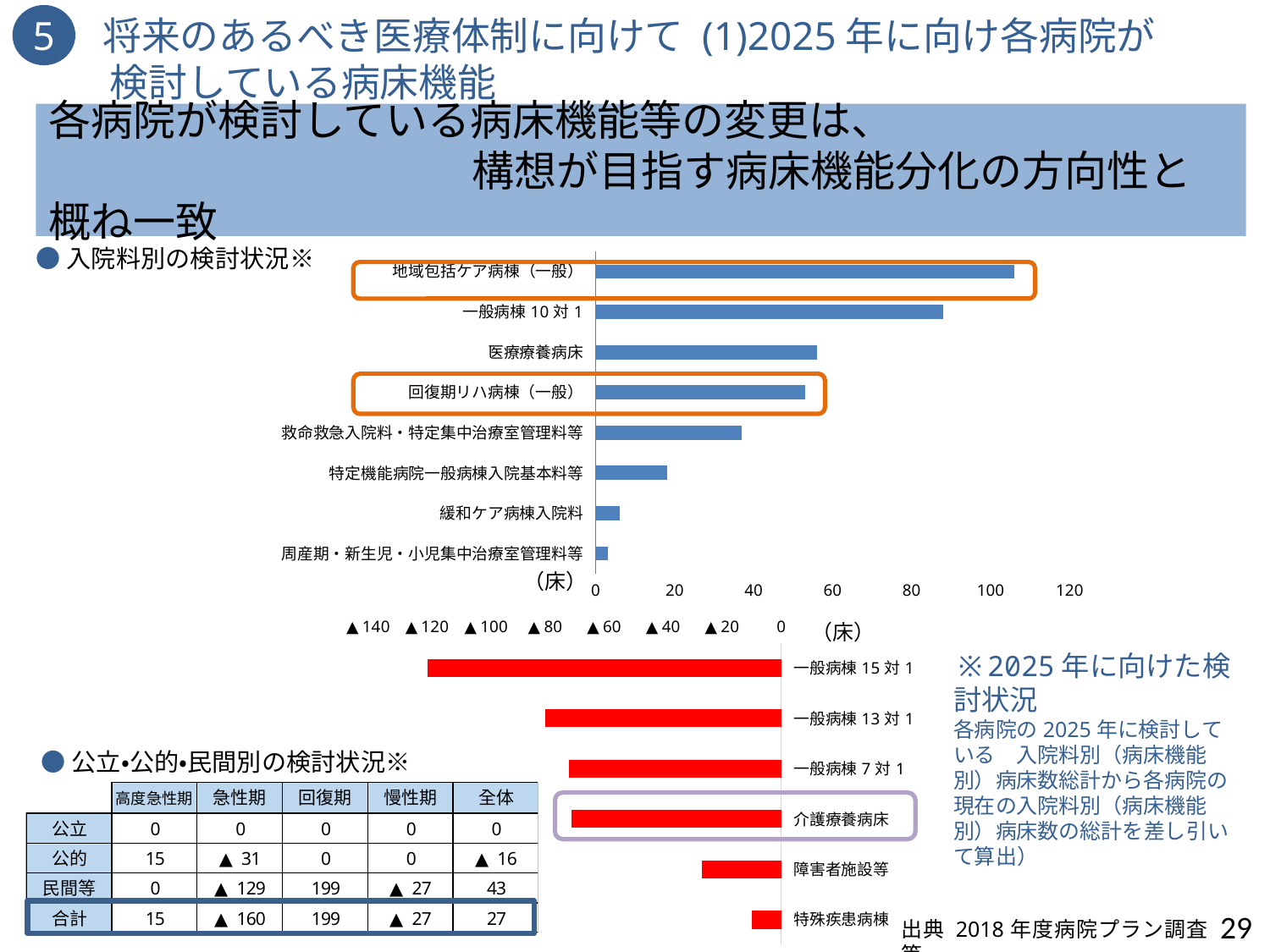
In the lower (red) bar chart, is the value for 一般病棟15対1 greater or less than ▲80? less In the upper (blue) bar chart, is the value for 地域包括ケア病棟（一般） greater or less than 100? greater In the lower (red) bar chart, which category has the largest decrease (longest bar)? 一般病棟15対1 How many categories does the lower (red) bar chart show? 6 In the upper (blue) bar chart, is the value for 一般病棟10対1 greater or less than 80? greater In the lower (red) bar chart, which category has the smallest decrease (shortest bar)? 特殊疾患病棟 In the upper (blue) bar chart, which category has the lowest value? 周産期・新生児・小児集中治療室管理料等 In the upper (blue) bar chart, which is larger: 一般病棟10対1 or 医療療養病床? 一般病棟10対1 How many categories does the upper (blue) bar chart show? 8 In the upper (blue) bar chart, which category has the highest value? 地域包括ケア病棟（一般） What kind of chart is the upper chart on the slide (the blue one)? bar chart